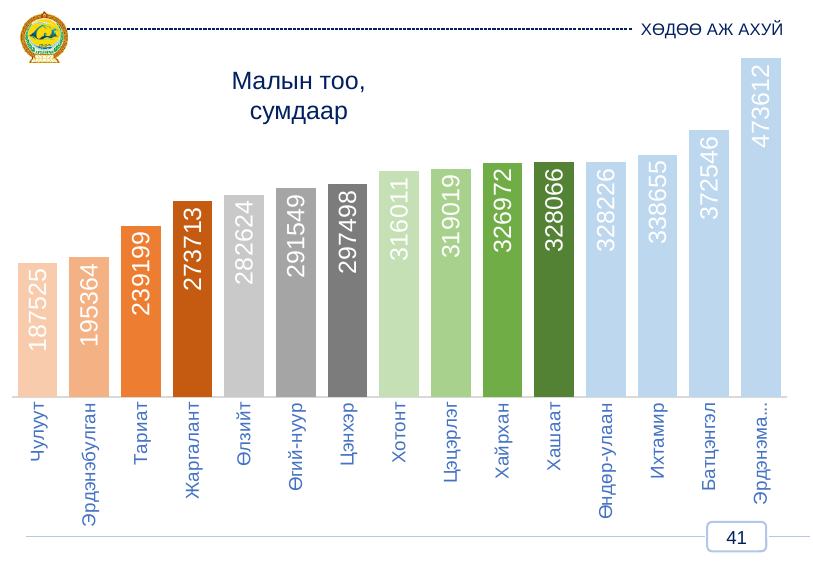
Which is larger, the value for Цэцэрлэг or the value for Өлзийт? Цэцэрлэг What is the difference between the values for Ихтамир and Хашаат? 10589 What is the title of the chart? Малын тоо, сумдаар What is the value for Батцэнгэл? 372546 What is the value for Өгий-нуур? 291549 How many categories are shown on the chart? 15 What kind of chart is shown on the slide? bar chart What is the value for Тариат? 239199 Which category has the lowest value? Чулуут What is the highest value shown on the chart? 473612 What is the value for Хотонт? 316011 What is the difference between the values for Жаргалант and Чулуут? 86188